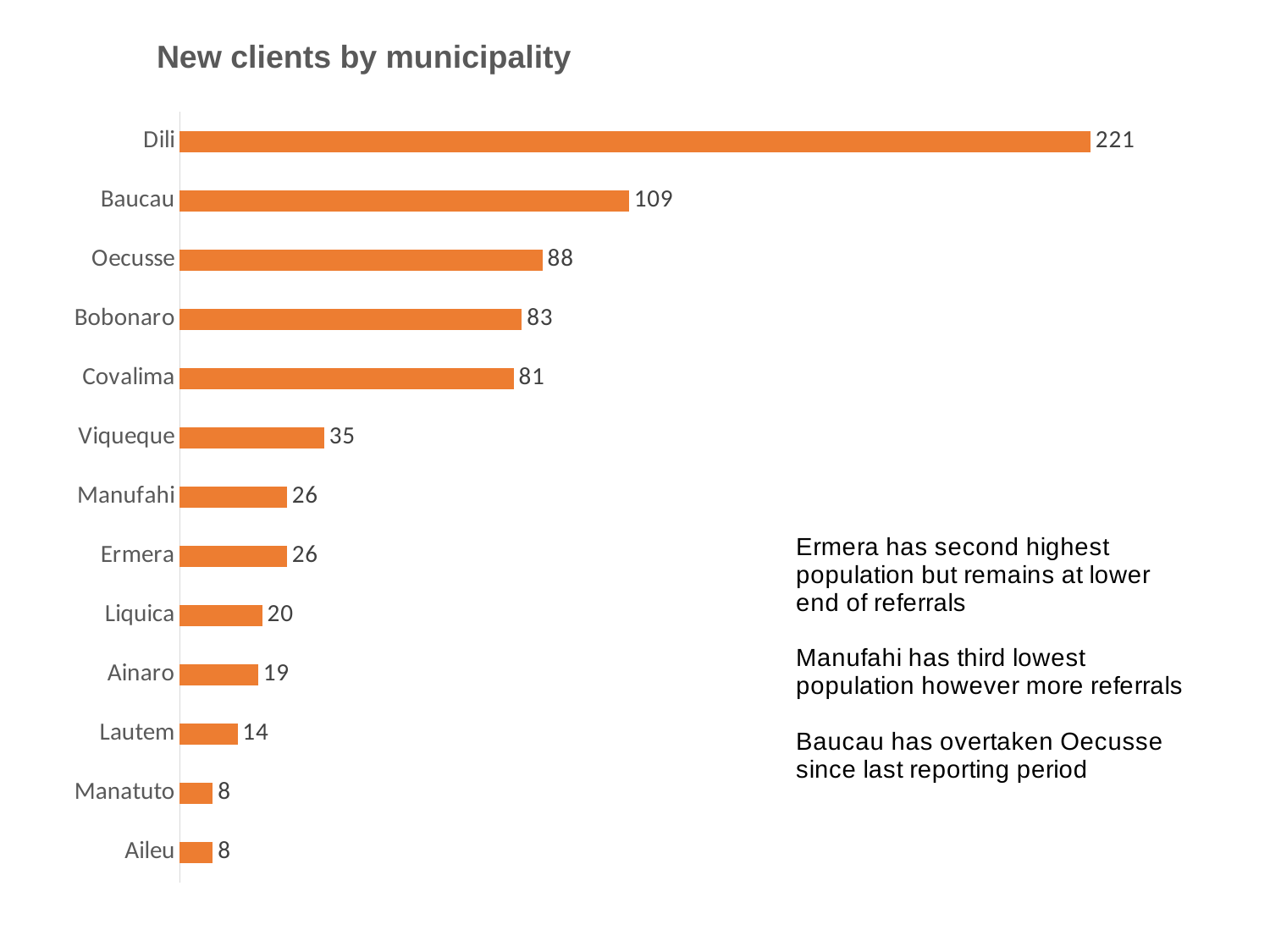
What is the difference between the values for Dili and Baucau? 112 What is the value for Lautem? 14 Which municipality has the highest number of new clients? Dili How many municipalities are shown in the chart? 13 Which is larger, the value for Viqueque or the value for Liquica? Viqueque What is the value for Covalima? 81 Which is larger, the value for Baucau or the value for Oecusse? Baucau What is the difference between the values for Oecusse and Bobonaro? 5 How many new clients does Dili have? 221 What colour are the bars in the chart? Orange What is the title of the chart? New clients by municipality What kind of chart is shown on the slide? Bar chart